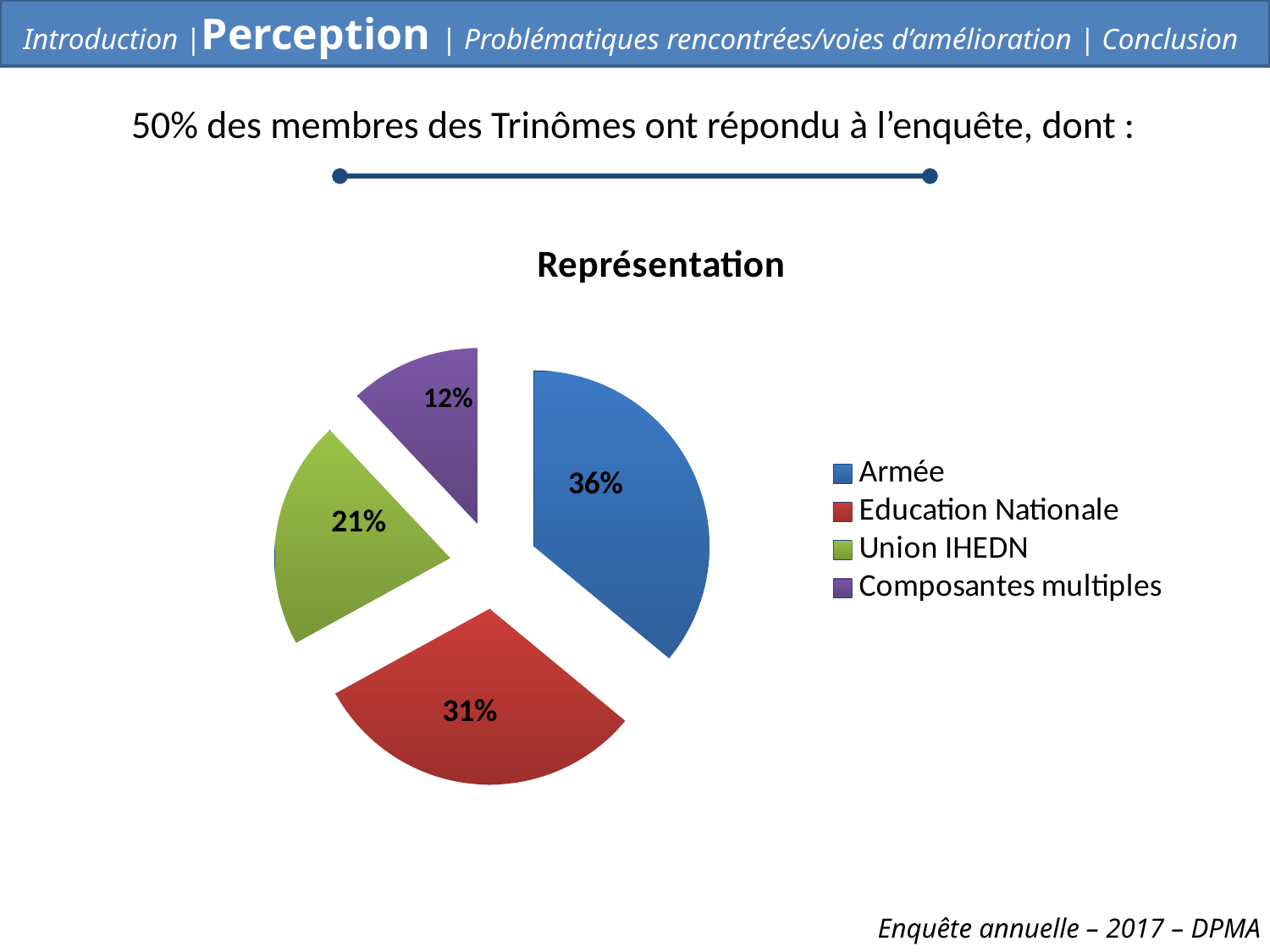
Which category has the smallest slice of the pie? Composantes multiples Which category has the largest slice of the pie? Armée What colour is the slice for Education Nationale? red What share of the pie does Armée represent? 36% What share of the pie does Education Nationale represent? 31% What share of the pie does Composantes multiples represent? 12% What is the difference in percentage points between Armée and Education Nationale? 5 What is the title of the chart? Représentation What type of chart is shown on the slide? pie chart How many categories does the pie chart show? 4 Which is larger, the share for Union IHEDN or the share for Composantes multiples? Union IHEDN